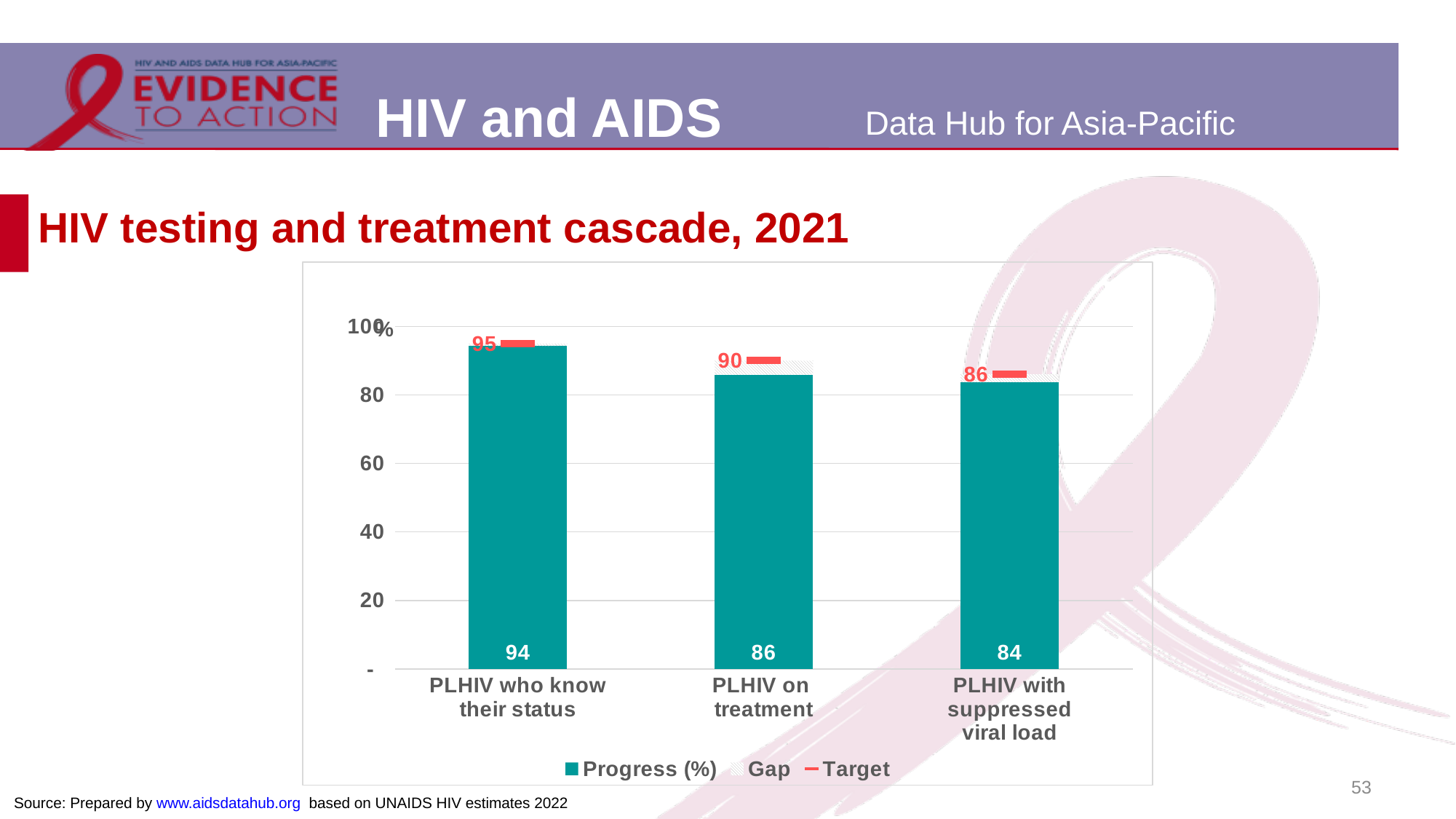
How many series does the legend list? 3 Which category has the lowest Progress (%) value? PLHIV with suppressed viral load Do the Progress (%) values rise or fall from left to right along the x axis? fall How many categories are shown on the x axis? 3 Is the Progress (%) for PLHIV who know their status greater or less than the Progress (%) for PLHIV on treatment? greater What is the Target value for PLHIV on treatment? 90 What is the Progress (%) value for PLHIV on treatment? 86 What is the Progress (%) value for PLHIV who know their status? 94 What is the difference between the Target and the Progress (%) for PLHIV on treatment? 4 What is the Target value for PLHIV with suppressed viral load? 86 What is the Progress (%) value for PLHIV with suppressed viral load? 84 Which category has the highest Progress (%) value? PLHIV who know their status